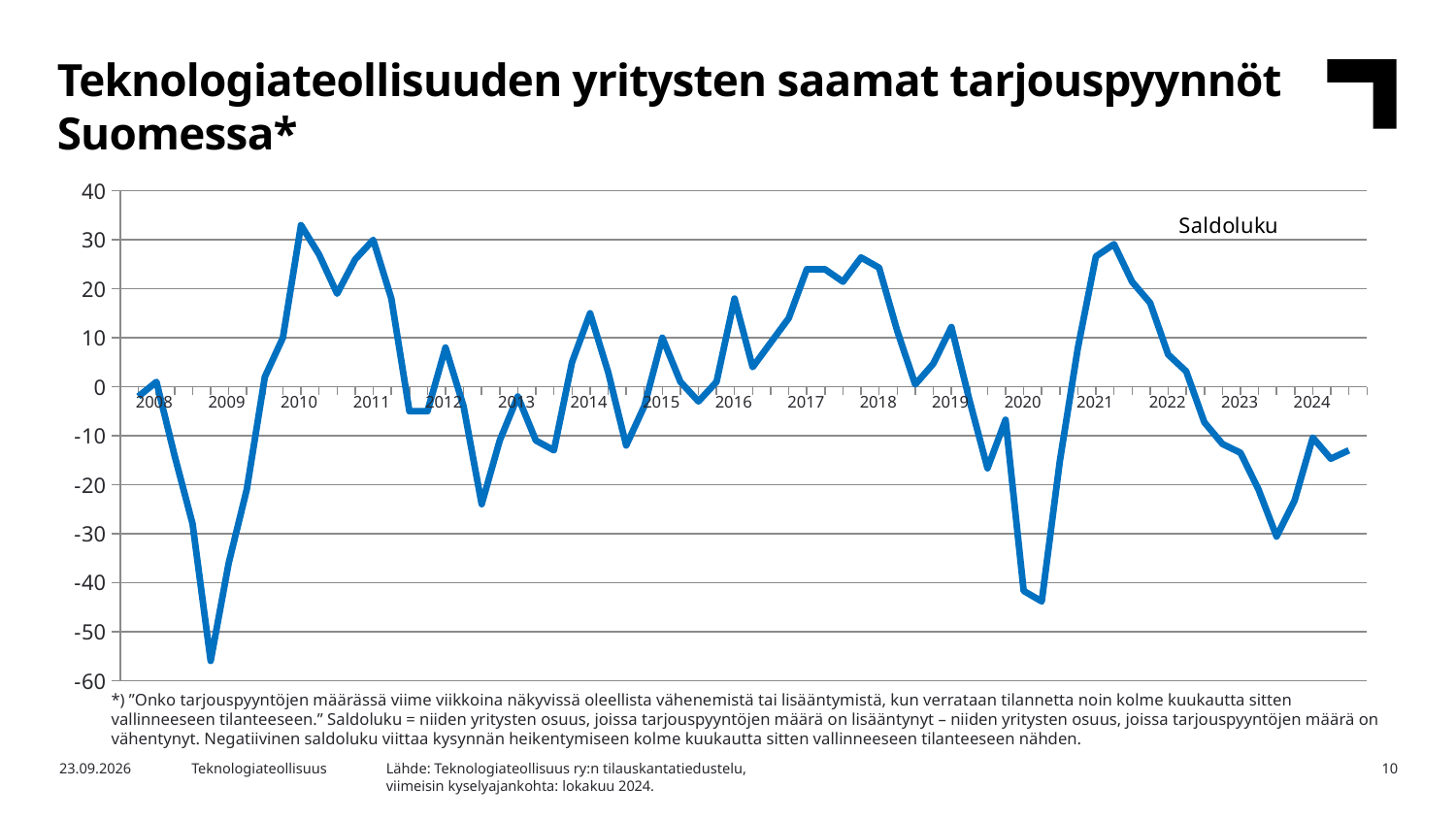
In which year does the Saldoluku line reach its lowest point? 2009 What is the name of the series plotted in the chart? Saldoluku Which is lower, the minimum of the Saldoluku line in 2009 or the minimum in 2020? 2009 Is the lowest value of the Saldoluku line in 2009 greater or less than -50? less Is the last plotted value of the Saldoluku line in 2024 greater or less than 0? less What is the title of the chart on the slide? Teknologiateollisuuden yritysten saamat tarjouspyynnöt Suomessa* Does the Saldoluku line rise or fall between its 2021 peak and 2023? fall Is the peak value of the Saldoluku line in 2010 greater or less than 30? greater How many series does the chart show? 1 How many years are labelled on the x axis of the chart? 17 What kind of chart is shown on the slide? line chart